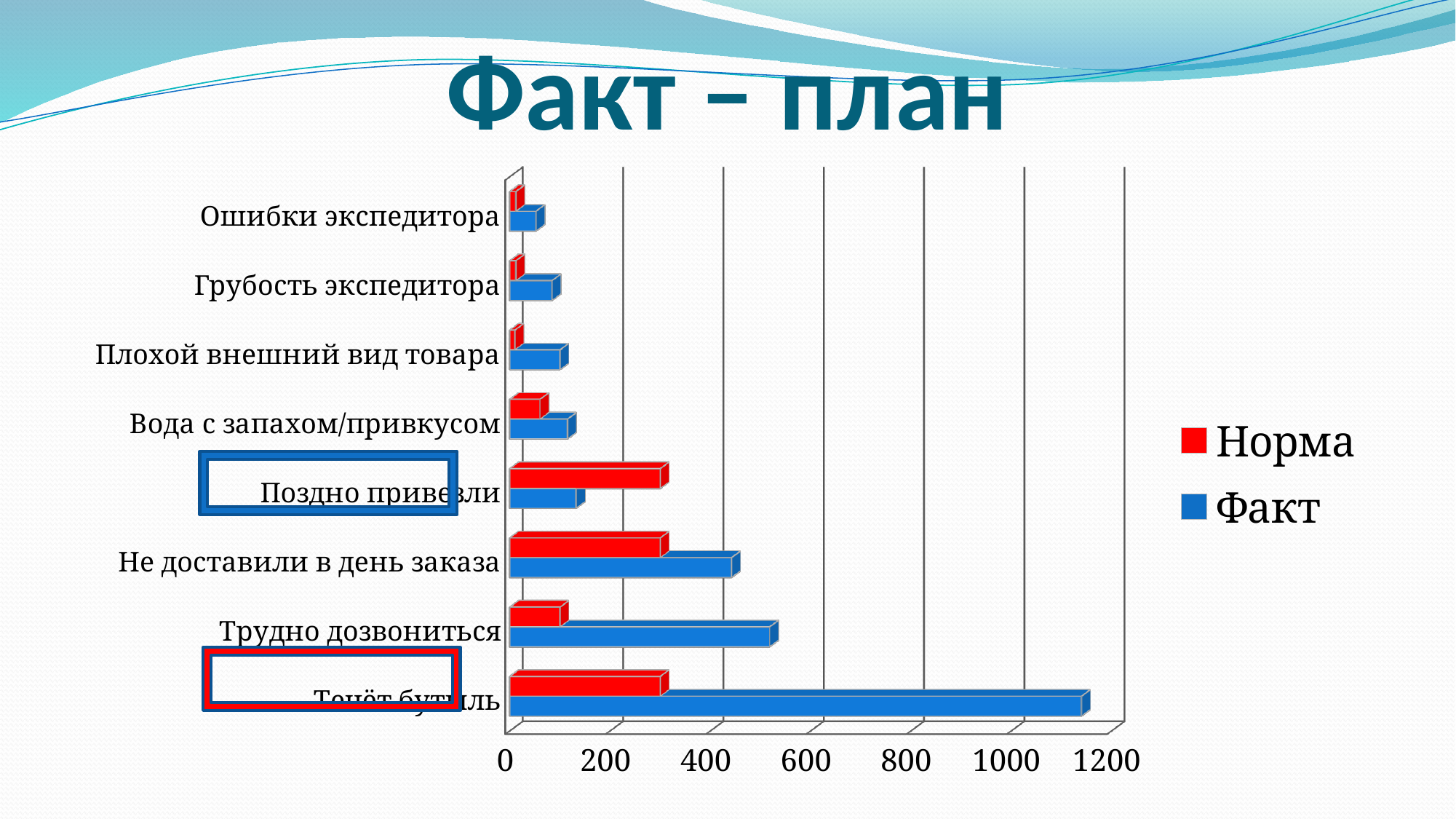
For Поздно привезли, which is larger: Норма or Факт? Норма Is the Факт value for Течёт бутыль greater or less than 1000? greater Is the Факт value for Поздно привезли greater or less than 200? less What kind of chart is shown on the slide? bar chart Is the Факт value for Трудно дозвониться greater or less than 400? greater Which category has the lowest Факт value? Ошибки экспедитора How many series does the legend list? 2 For Течёт бутыль, which is larger: Норма or Факт? Факт Which colour represents the Норма series in the legend? red How many categories are plotted on the chart? 8 Which category has the highest Факт value? Течёт бутыль